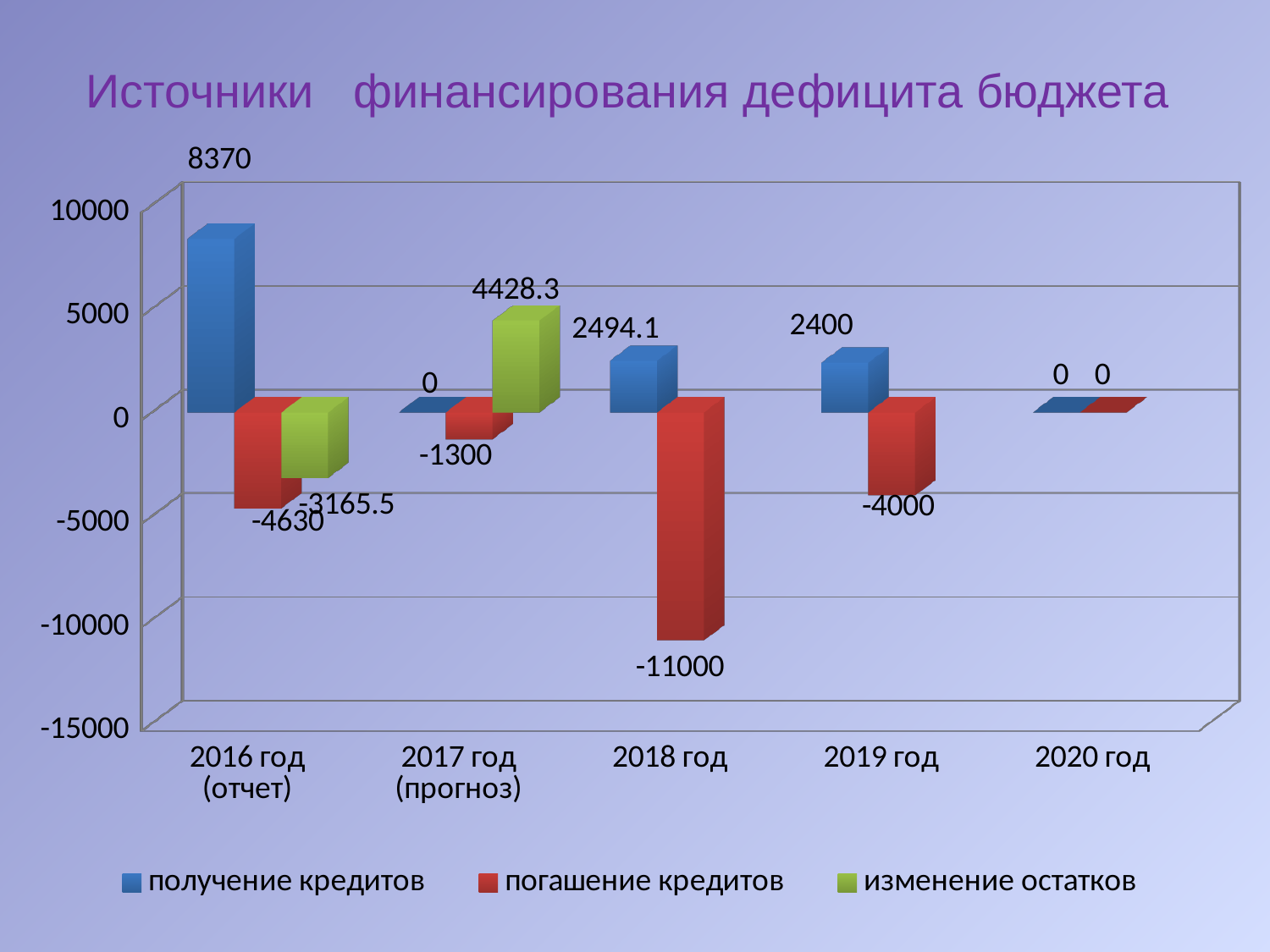
What is the value of погашение кредитов for 2019 год? -4000 What is the value of получение кредитов for 2016 год (отчет)? 8370 What is the value of изменение остатков for 2017 год (прогноз)? 4428.3 What is the value of погашение кредитов for 2018 год? -11000 What is the difference between получение кредитов in 2018 год and 2019 год? 94.1 In which year is получение кредитов highest? 2016 год (отчет) What type of chart is shown on the slide? bar chart How many year categories are shown on the x axis? 5 In which year is погашение кредитов lowest (most negative)? 2018 год What is the value of изменение остатков for 2016 год (отчет)? -3165.5 Which is larger: получение кредитов in 2016 год (отчет) or изменение остатков in 2017 год (прогноз)? получение кредитов in 2016 год (отчет) How many series does the legend list? 3